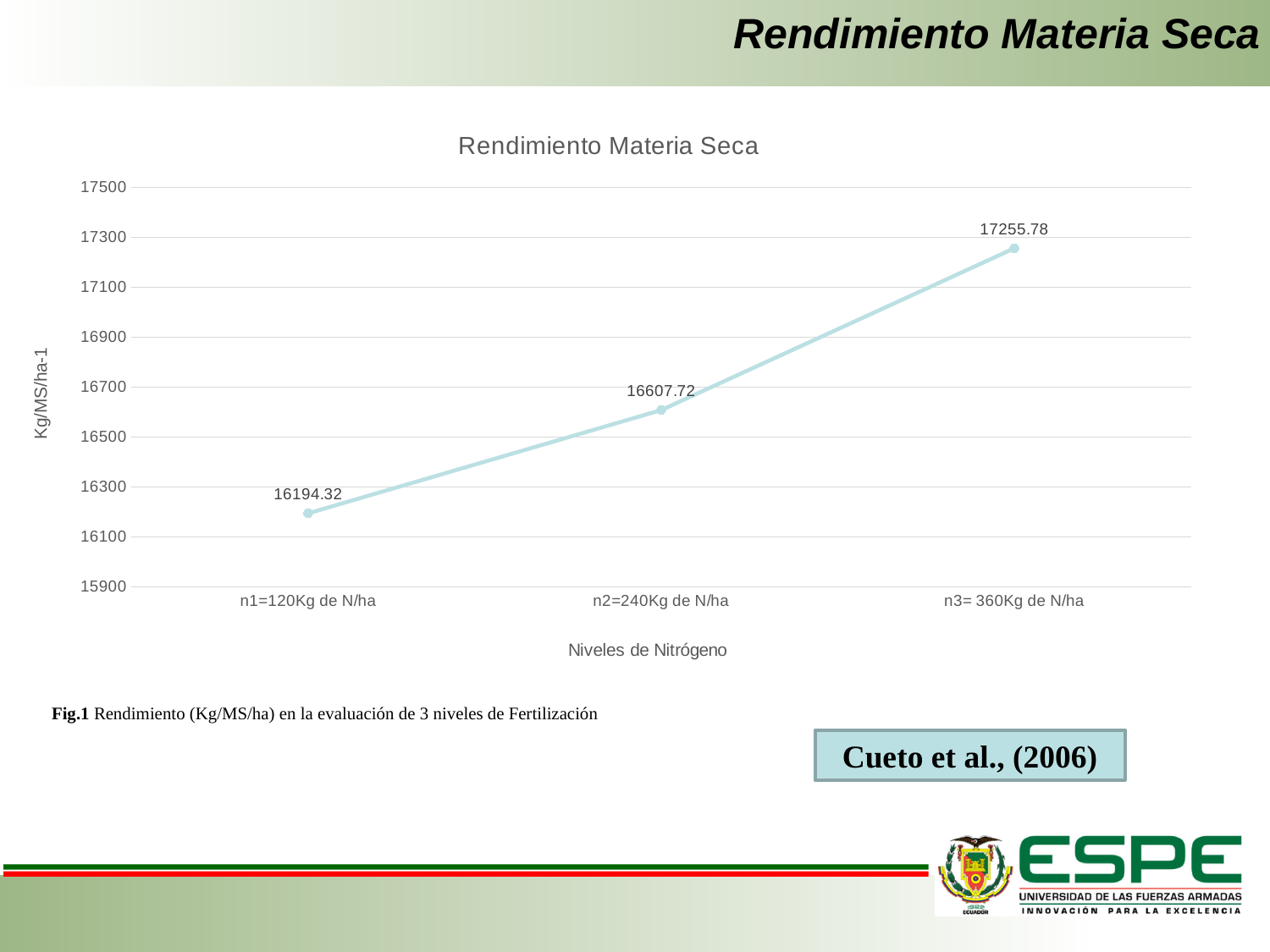
Which nitrogen level has the highest Rendimiento Materia Seca? n3= 360Kg de N/ha Is the value for n2=240Kg de N/ha greater or less than 16500? greater Which nitrogen level has the lowest Rendimiento Materia Seca? n1=120Kg de N/ha How many nitrogen levels are plotted on the chart? 3 What is the value for n2=240Kg de N/ha? 16607.72 What is the difference between the values for n2=240Kg de N/ha and n1=120Kg de N/ha? 413.40 Do the values rise or fall as the nitrogen level increases along the x axis? rise What is the difference between the values for n3= 360Kg de N/ha and n1=120Kg de N/ha? 1061.46 What is the value for n3= 360Kg de N/ha? 17255.78 What kind of chart is shown on the slide? line chart Which is larger, the value for n2=240Kg de N/ha or the value for n3= 360Kg de N/ha? n3= 360Kg de N/ha What is the value for n1=120Kg de N/ha? 16194.32